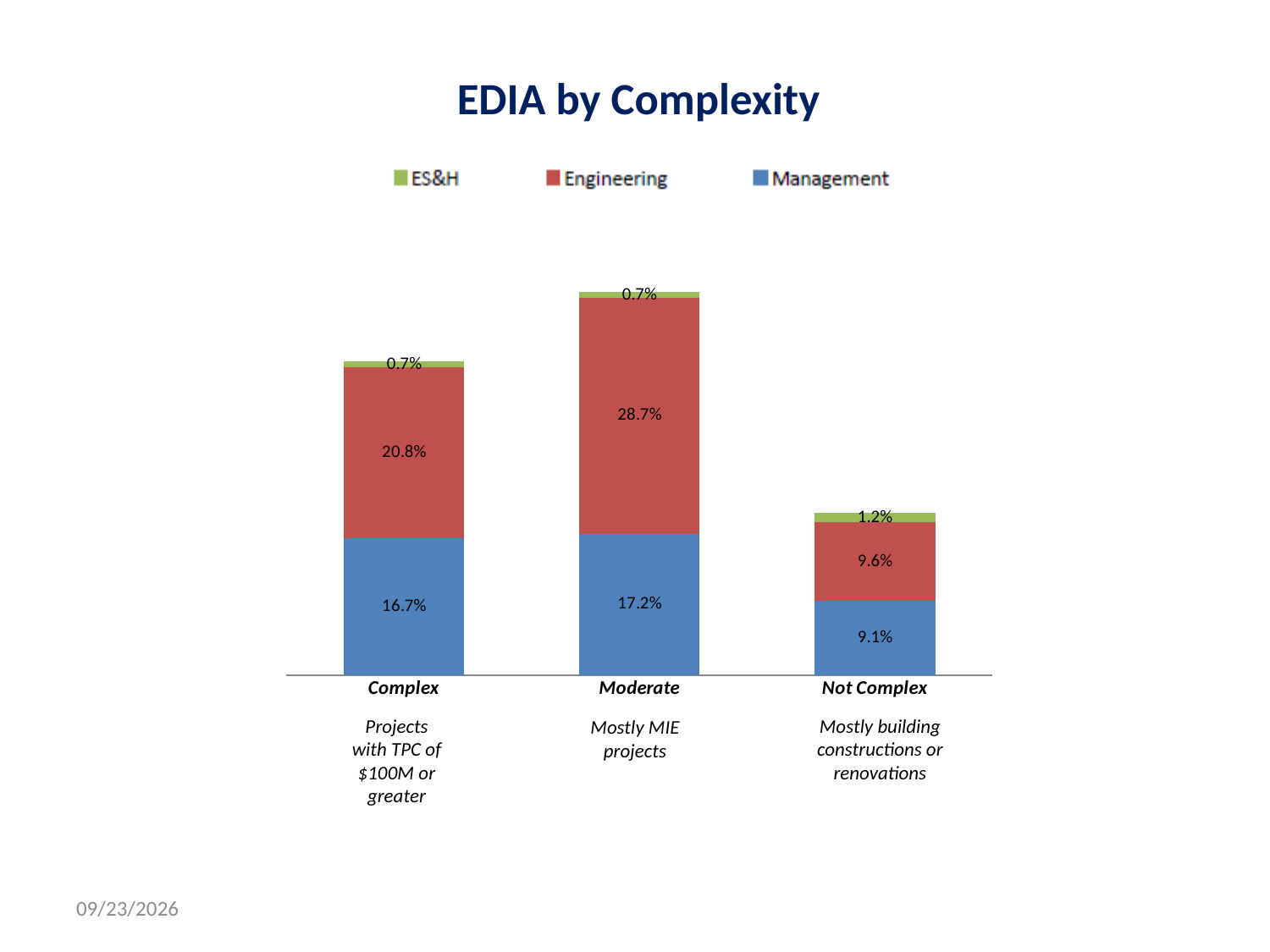
What kind of chart is shown on the slide? Stacked bar chart What is the Management value for the Not Complex category? 9.1% What is the Engineering value for the Moderate category? 28.7% Which category has the highest Engineering value? Moderate What is the total of the stacked bar for the Complex category? 38.2% How many series does the legend list? 3 How many categories are shown on the x axis? 3 Which category has the lowest Management value? Not Complex What is the ES&H value for the Not Complex category? 1.2% Which is larger, the Management value for Complex or the Management value for Moderate? Moderate What is the difference between the Engineering values for Moderate and Complex? 7.9% What is the total of the stacked bar for the Not Complex category? 19.9%